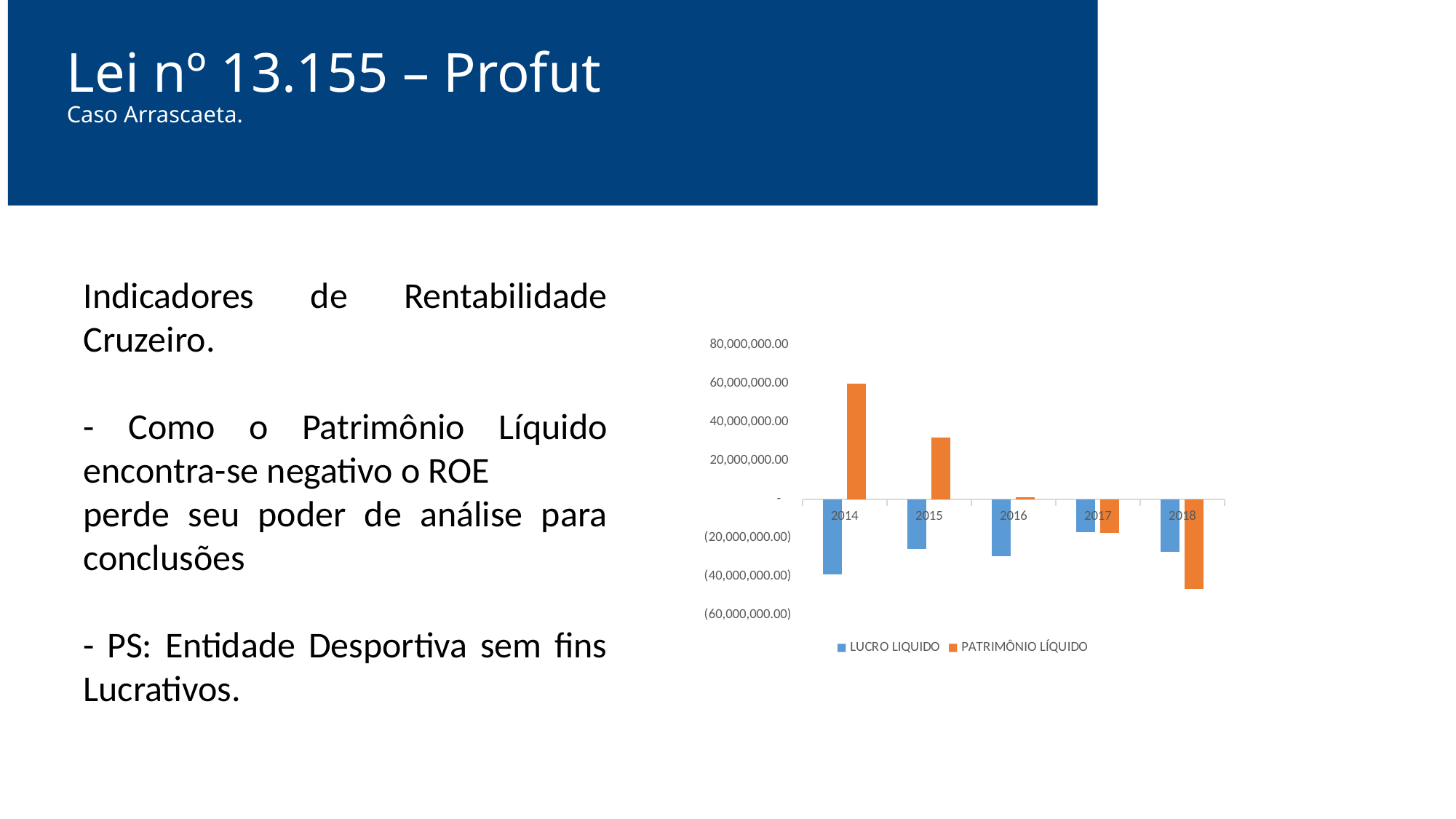
How many series does the chart's legend list? 2 In which year is LUCRO LIQUIDO lowest? 2014 Which series is shown in blue in the chart? LUCRO LIQUIDO Is the value for PATRIMÔNIO LÍQUIDO in 2014 greater or less than 40,000,000.00? greater What kind of chart is shown on the slide? bar chart Which series is shown in orange in the chart? PATRIMÔNIO LÍQUIDO Is the value for PATRIMÔNIO LÍQUIDO in 2018 greater or less than (40,000,000.00)? less Does PATRIMÔNIO LÍQUIDO rise or fall from 2014 to 2018? fall Which is larger in 2015, LUCRO LIQUIDO or PATRIMÔNIO LÍQUIDO? PATRIMÔNIO LÍQUIDO In which year is PATRIMÔNIO LÍQUIDO lowest? 2018 In which year is PATRIMÔNIO LÍQUIDO highest? 2014 How many years are shown on the x axis of the chart? 5